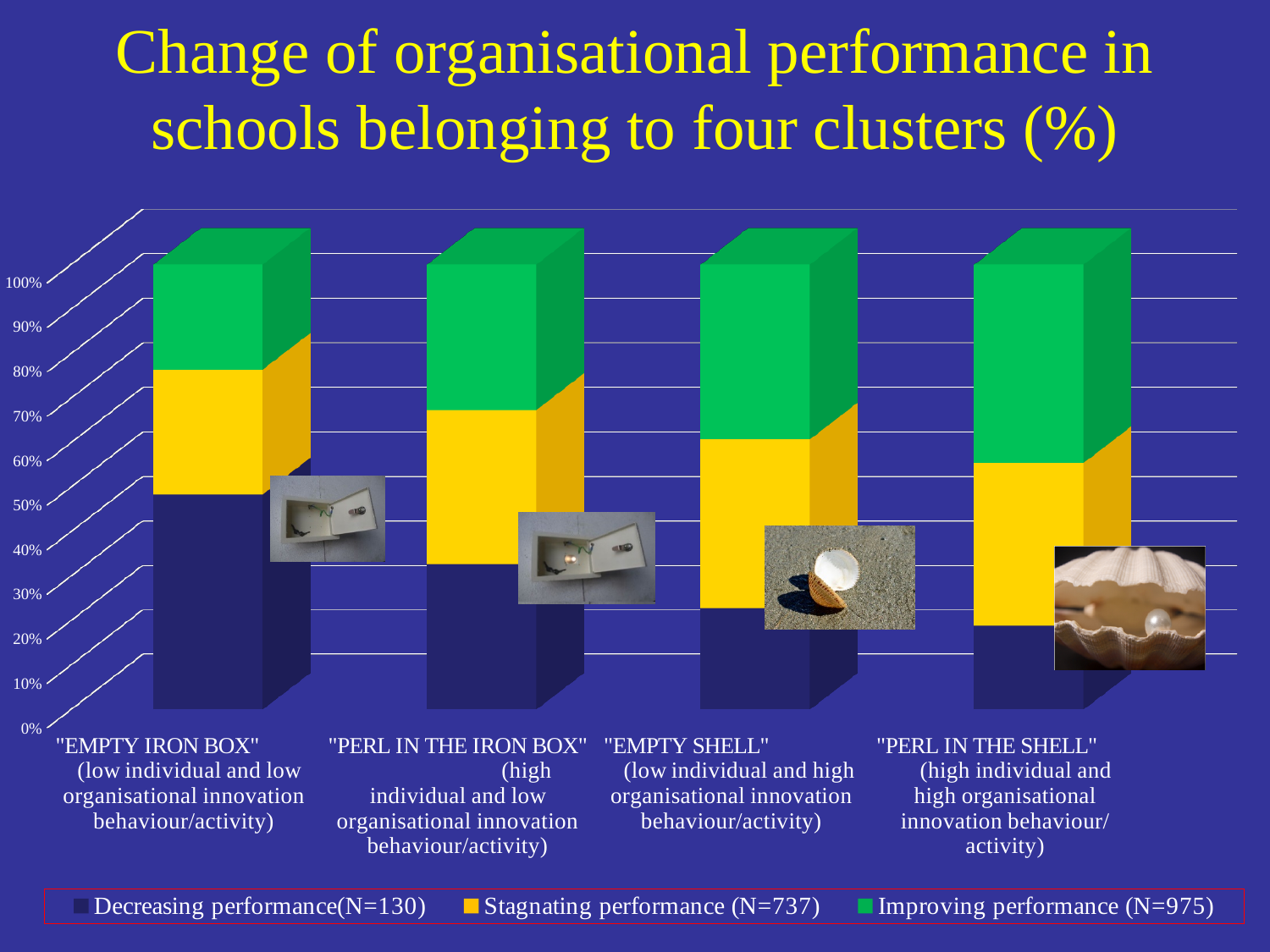
Is the Improving performance share in the "PERL IN THE SHELL" cluster greater or less than 30%? greater Which cluster has the largest share of Decreasing performance? "EMPTY IRON BOX" How many series does the chart's legend list? 3 Is the value for Decreasing performance in the "EMPTY IRON BOX" cluster greater or less than 40%? greater What kind of chart is shown on the slide? Stacked bar chart How many clusters (categories) are shown on the x axis of the chart? 4 Which cluster has the smallest share of Decreasing performance? "PERL IN THE SHELL" Does the Decreasing performance share rise or fall across the clusters from left to right? fall Which is larger: the Decreasing performance share in "EMPTY IRON BOX" or in "EMPTY SHELL"? "EMPTY IRON BOX" Is the value for Decreasing performance in the "PERL IN THE SHELL" cluster greater or less than 30%? less According to the legend, what is the N for Decreasing performance? N=130